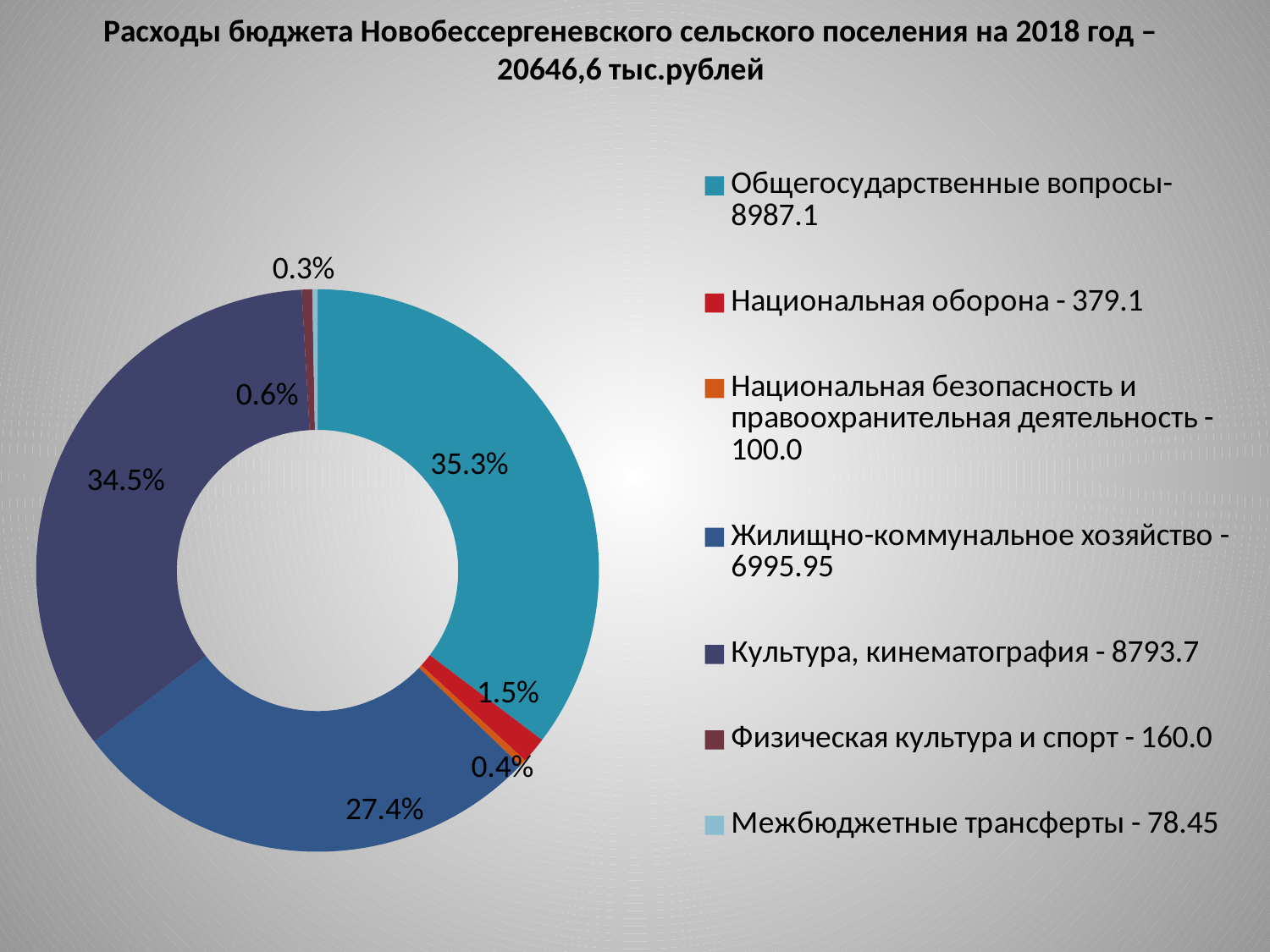
What amount does the legend give for Жилищно-коммунальное хозяйство? 6995.95 Which category has the smallest share of the chart? Межбюджетные трансферты What share of the chart does Общегосударственные вопросы account for? 35.3% How many categories does the chart show? 7 What type of chart is shown on the slide? Doughnut (pie) chart Which slice is larger: Физическая культура и спорт or Национальная безопасность и правоохранительная деятельность? Физическая культура и спорт Which category has the largest share of the chart? Общегосударственные вопросы What amount does the legend give for Межбюджетные трансферты? 78.45 What percentage is shown for the Жилищно-коммунальное хозяйство slice? 27.4% What percentage is shown for the Культура, кинематография slice? 34.5% What percentage is shown for the Национальная оборона slice? 1.5% What is the difference in percentage points between the Общегосударственные вопросы slice and the Жилищно-коммунальное хозяйство slice? 7.9 percentage points